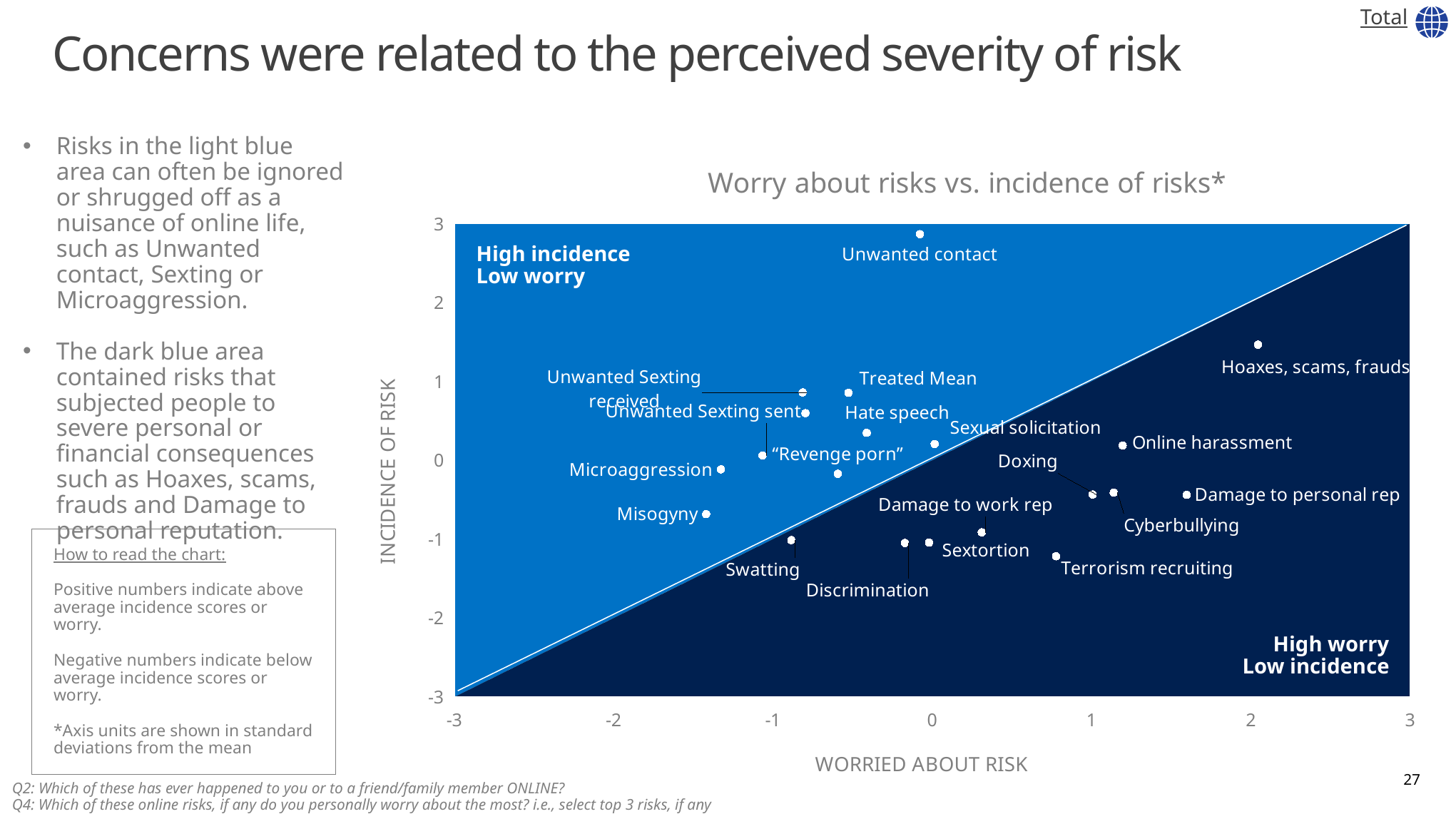
Which risk has the highest worried about risk value in the chart? Hoaxes, scams, frauds Is the worried about risk value for Online harassment greater or less than 1? greater Which risk has the highest incidence of risk value in the chart? Unwanted contact Is the worried about risk value for Misogyny greater or less than -1? less Is the worried about risk value for Hoaxes, scams, frauds greater or less than 1? greater Which has a higher incidence of risk value, Unwanted contact or Hoaxes, scams, frauds? Unwanted contact Which has a higher worried about risk value, Terrorism recruiting or Microaggression? Terrorism recruiting What kind of chart is shown on the slide? Scatter chart What is the label of the vertical axis of the chart? INCIDENCE OF RISK What is the title of the chart? Worry about risks vs. incidence of risks*